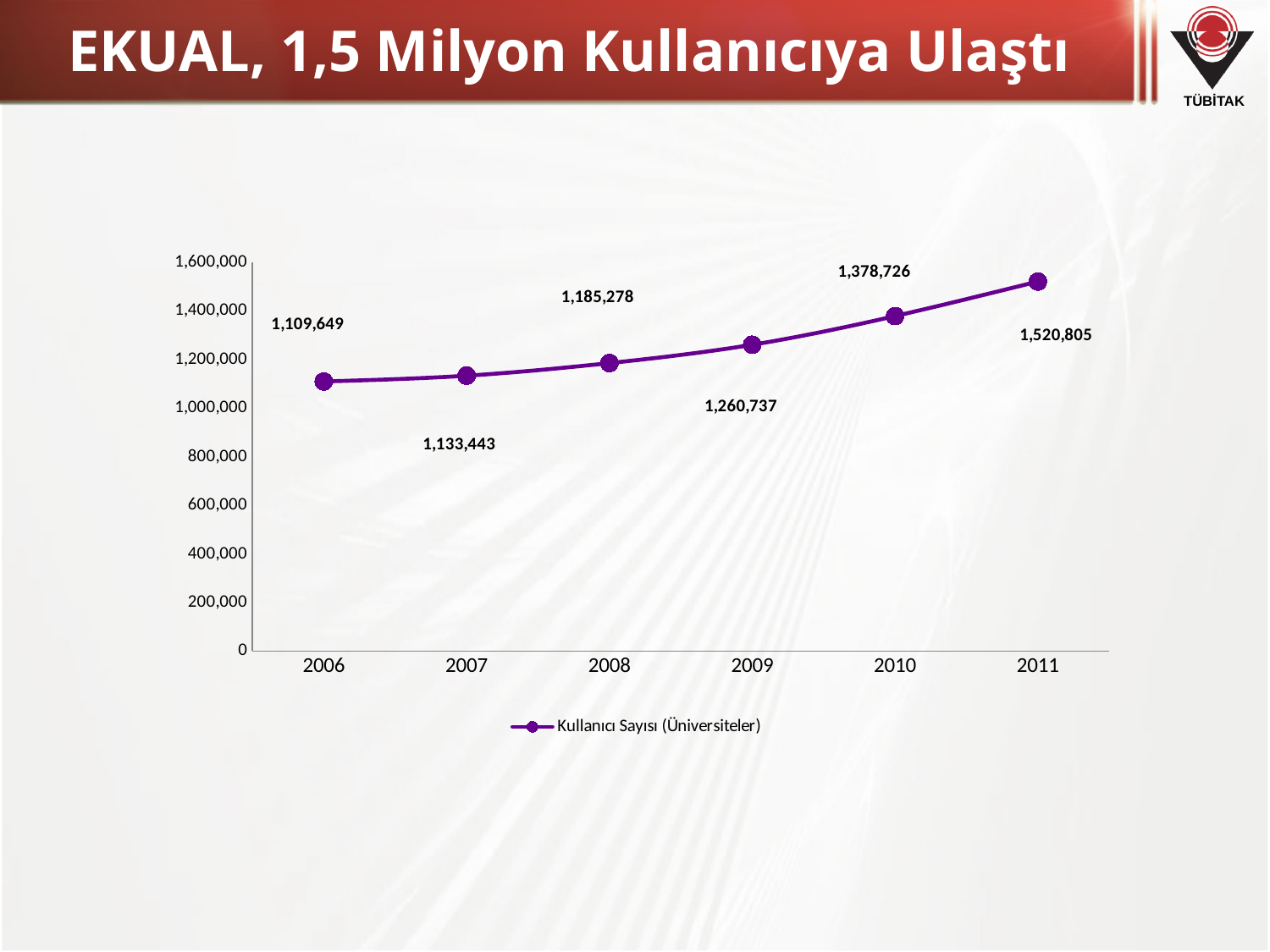
What is the difference between the values for 2011 and 2006? 411,156 What is the value for 2006? 1,109,649 Do the values rise or fall from 2006 to 2011? rise Which year has the lowest value? 2006 What is the value for 2009? 1,260,737 What is the value for 2011? 1,520,805 Is the value for 2011 greater or less than 1,400,000? greater Which is larger, the value for 2008 or the value for 2010? 2010 How many years are plotted on the x axis? 6 What is the difference between the values for 2010 and 2009? 117,989 Which year has the highest value? 2011 What kind of chart is shown? line chart